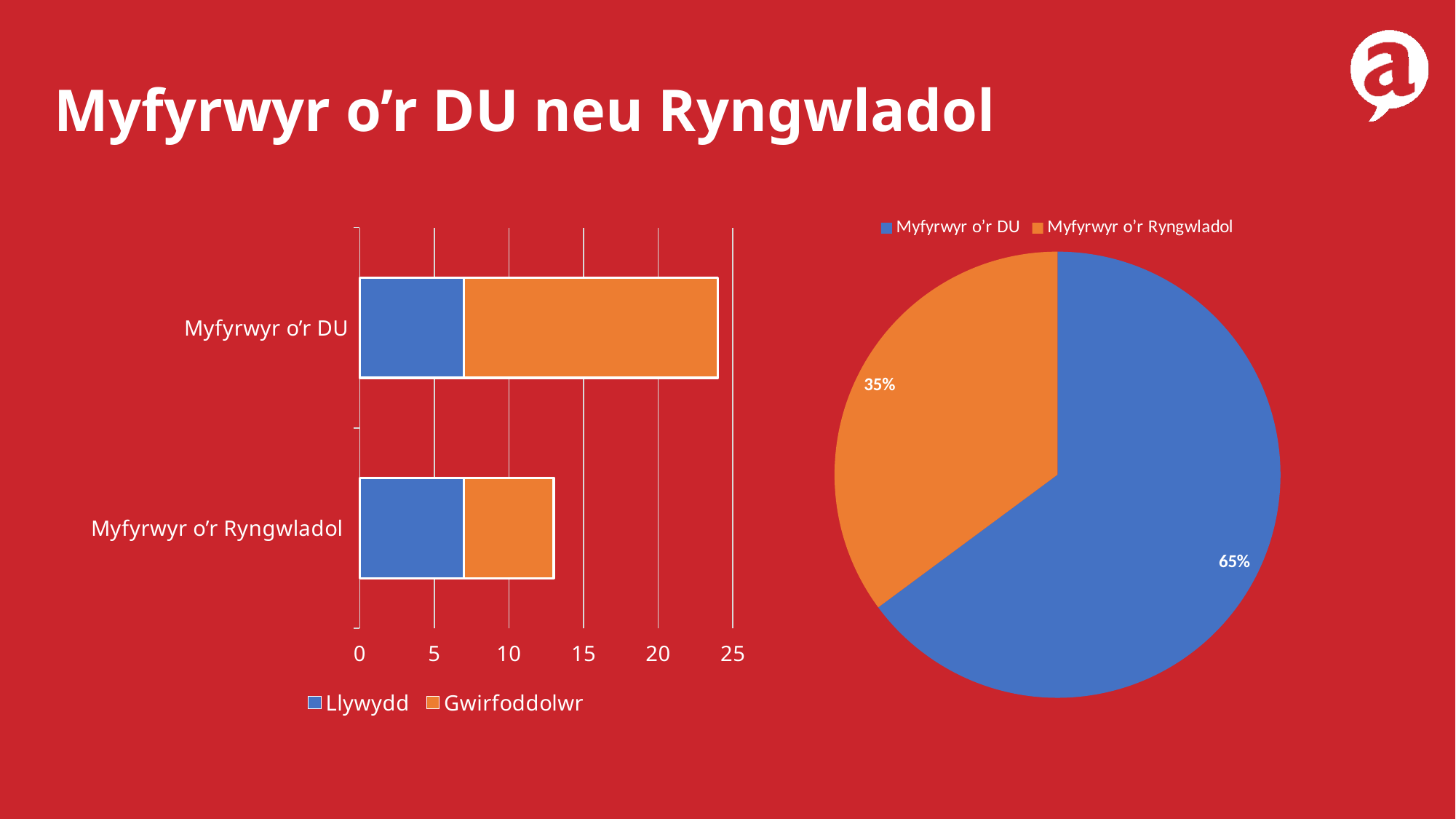
In the bar chart on the left, which category has the longer stacked bar overall, Myfyrwyr o’r DU or Myfyrwyr o’r Ryngwladol? Myfyrwyr o’r DU In the bar chart on the left, is the total length of the stacked bar for Myfyrwyr o’r Ryngwladol greater or less than 15? less In the bar chart on the left, how many categories are shown on the vertical axis? 2 In the pie chart on the right, what share is shown for Myfyrwyr o’r Ryngwladol? 35% In the bar chart on the left, is the total length of the stacked bar for Myfyrwyr o’r DU greater or less than 20? greater In the pie chart on the right, how many slices are there? 2 In the pie chart on the right, which slice is the largest? Myfyrwyr o’r DU In the pie chart on the right, what is the difference in percentage points between the Myfyrwyr o’r DU slice and the Myfyrwyr o’r Ryngwladol slice? 30% In the bar chart on the left, how many series does the legend list? 2 What kind of chart is the chart on the right of the slide? pie chart What kind of chart is the chart on the left of the slide? bar chart In the pie chart on the right, what share is shown for Myfyrwyr o’r DU? 65%